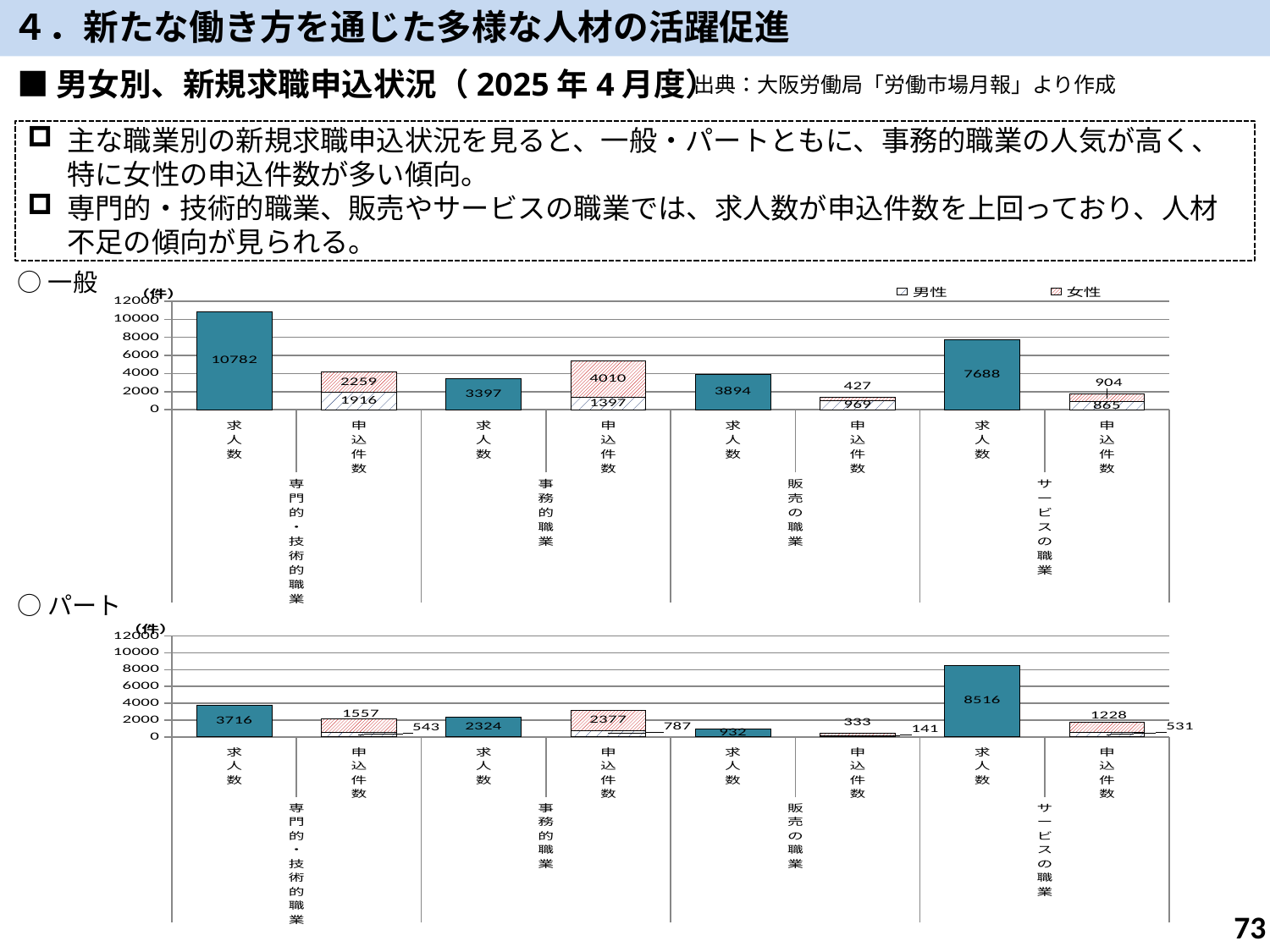
In the パート chart (bottom), what is the 男性 申込件数 value for 販売の職業? 141 In the 一般 chart (top), which occupation has the highest 求人数? 専門的・技術的職業 In the 一般 chart (top), what is the difference between the 求人数 for サービスの職業 and the 求人数 for 事務的職業? 4291 In the 一般 chart (top), what is the 女性 申込件数 value for 事務的職業? 4010 In the パート chart (bottom), which occupation has the lowest 求人数? 販売の職業 What kind of chart is the パート chart (bottom)? Bar chart In the 一般 chart (top), what is the 求人数 value for 専門的・技術的職業? 10782 In the パート chart (bottom), what is the total 申込件数 (男性 + 女性) for 事務的職業? 3164 In the 一般 chart (top), what is the total 申込件数 (男性 + 女性) for 販売の職業? 1396 In the パート chart (bottom), which is larger for 専門的・技術的職業: the 女性 申込件数 or the 男性 申込件数? 女性 申込件数 How many series does the legend of the 一般 chart (top) list? 2 In the パート chart (bottom), what is the 求人数 value for サービスの職業? 8516